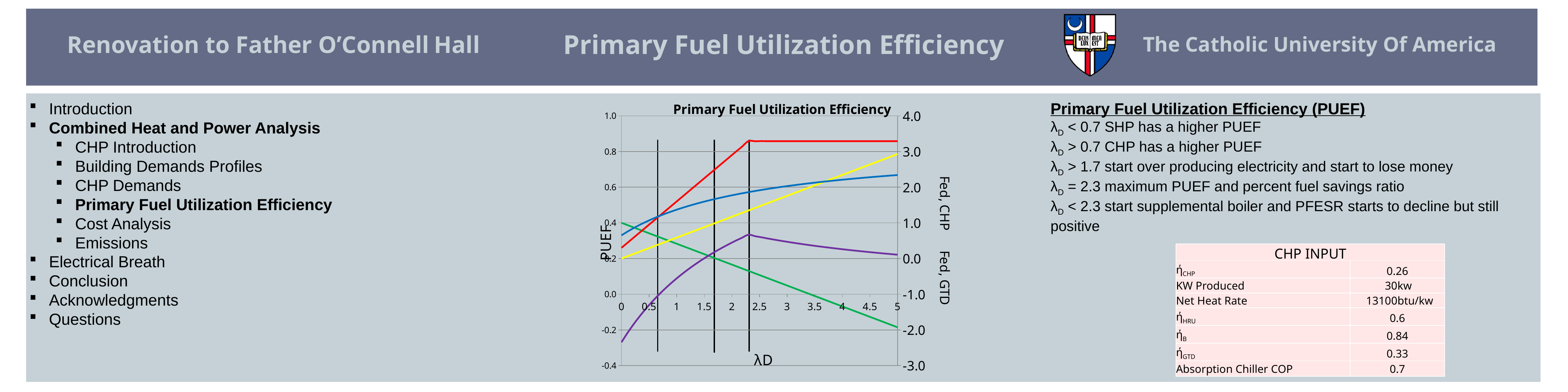
How many tick labels are shown on the x axis of the chart? 11 Does the yellow line rise or fall as λD increases from 0 to 5? rise On the left-hand PUEF axis, is the green line at λD = 5 greater or less than 0.0? less On the left-hand PUEF axis, is the yellow line at λD = 0 greater or less than 0.4? less On the left-hand PUEF axis, is the red line at λD = 5 greater or less than 0.8? greater At λD = 5, is the red line higher or lower on the chart than the blue line? higher What is the label on the x axis of the chart? λD At λD = 0, is the blue line higher or lower on the chart than the red line? higher Does the green line rise or fall as λD increases from 0 to 5? fall What is the title of the chart? Primary Fuel Utilization Efficiency Does the blue line rise or fall as λD increases from 0 to 5? rise What kind of chart is shown on the slide? line chart